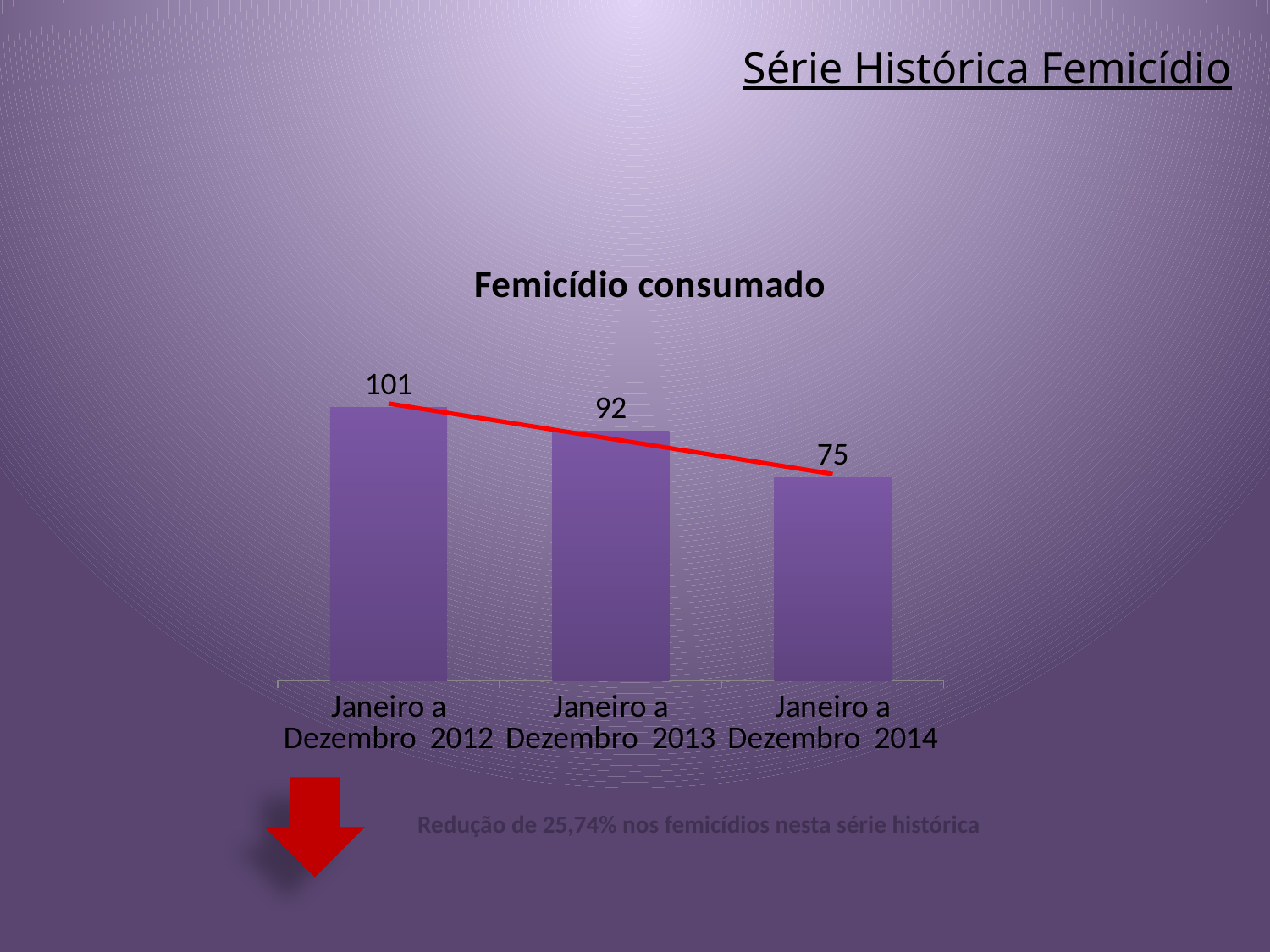
What is the title of the chart? Femicídio consumado Which period has the highest value? Janeiro a Dezembro 2012 What is the value for Janeiro a Dezembro 2014? 75 What kind of chart is this? bar chart What is the difference between the values for Janeiro a Dezembro 2012 and Janeiro a Dezembro 2014? 26 Do the values rise or fall from 2012 to 2014? fall How many periods are shown on the chart? 3 What is the value for Janeiro a Dezembro 2013? 92 Which period has the lowest value? Janeiro a Dezembro 2014 What is the difference between the values for Janeiro a Dezembro 2012 and Janeiro a Dezembro 2013? 9 Which is larger, the value for Janeiro a Dezembro 2013 or Janeiro a Dezembro 2014? Janeiro a Dezembro 2013 What is the value for Janeiro a Dezembro 2012? 101